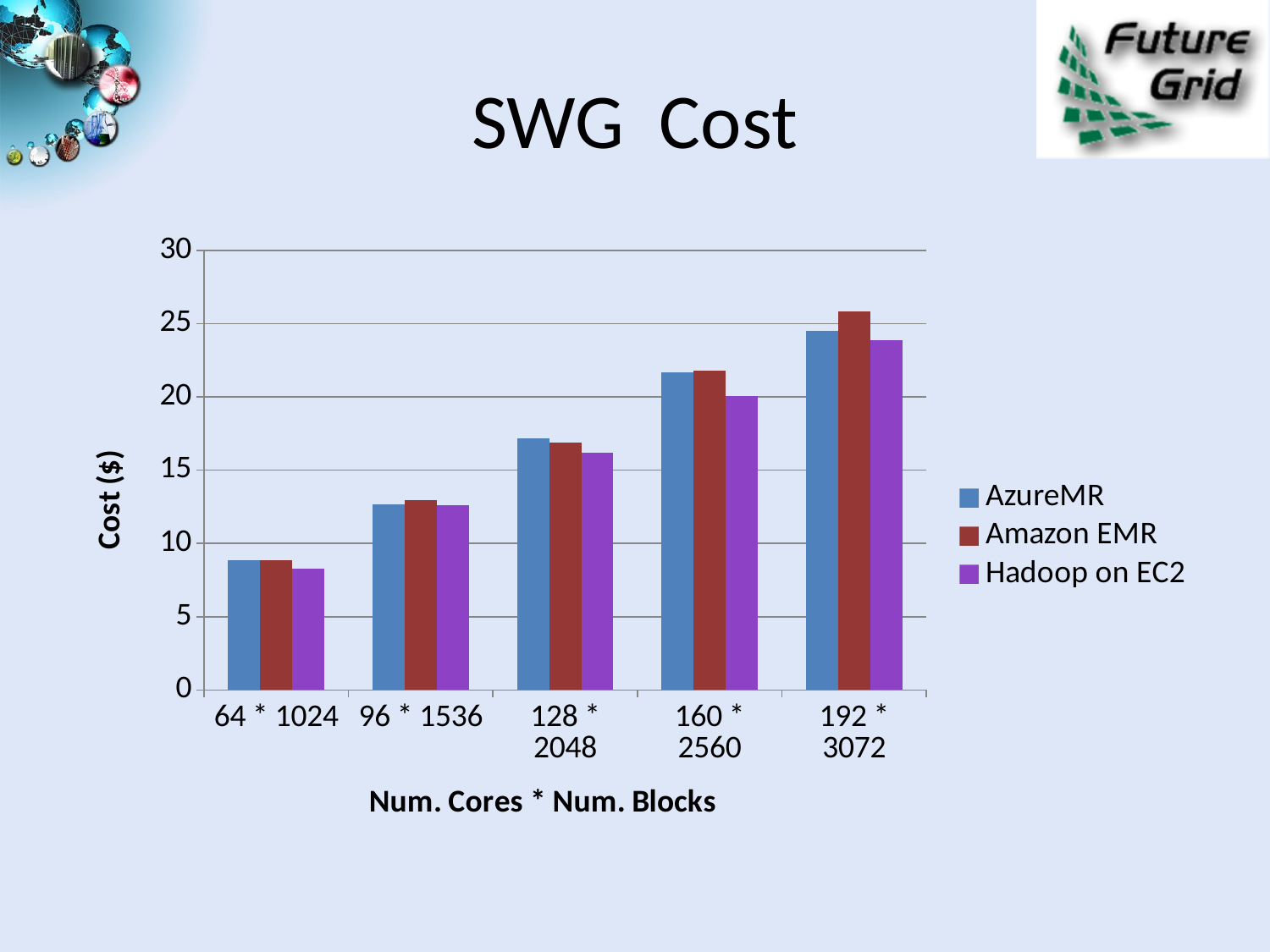
For which category is the Hadoop on EC2 cost lowest? 64 * 1024 Is the Hadoop on EC2 value for 128 * 2048 greater or less than 15? greater Is the Amazon EMR value for 192 * 3072 greater or less than 25? greater Is the AzureMR value for 64 * 1024 greater or less than 10? less What is the label of the y axis? Cost ($) Do the AzureMR costs rise or fall as the number of cores and blocks increases along the x axis? rise At 192 * 3072, which is larger: the Amazon EMR cost or the Hadoop on EC2 cost? Amazon EMR How many categories are shown on the x axis? 5 For which category is the Amazon EMR cost highest? 192 * 3072 What is the title of the chart? SWG Cost What kind of chart is shown on the slide? bar chart How many series does the legend list? 3